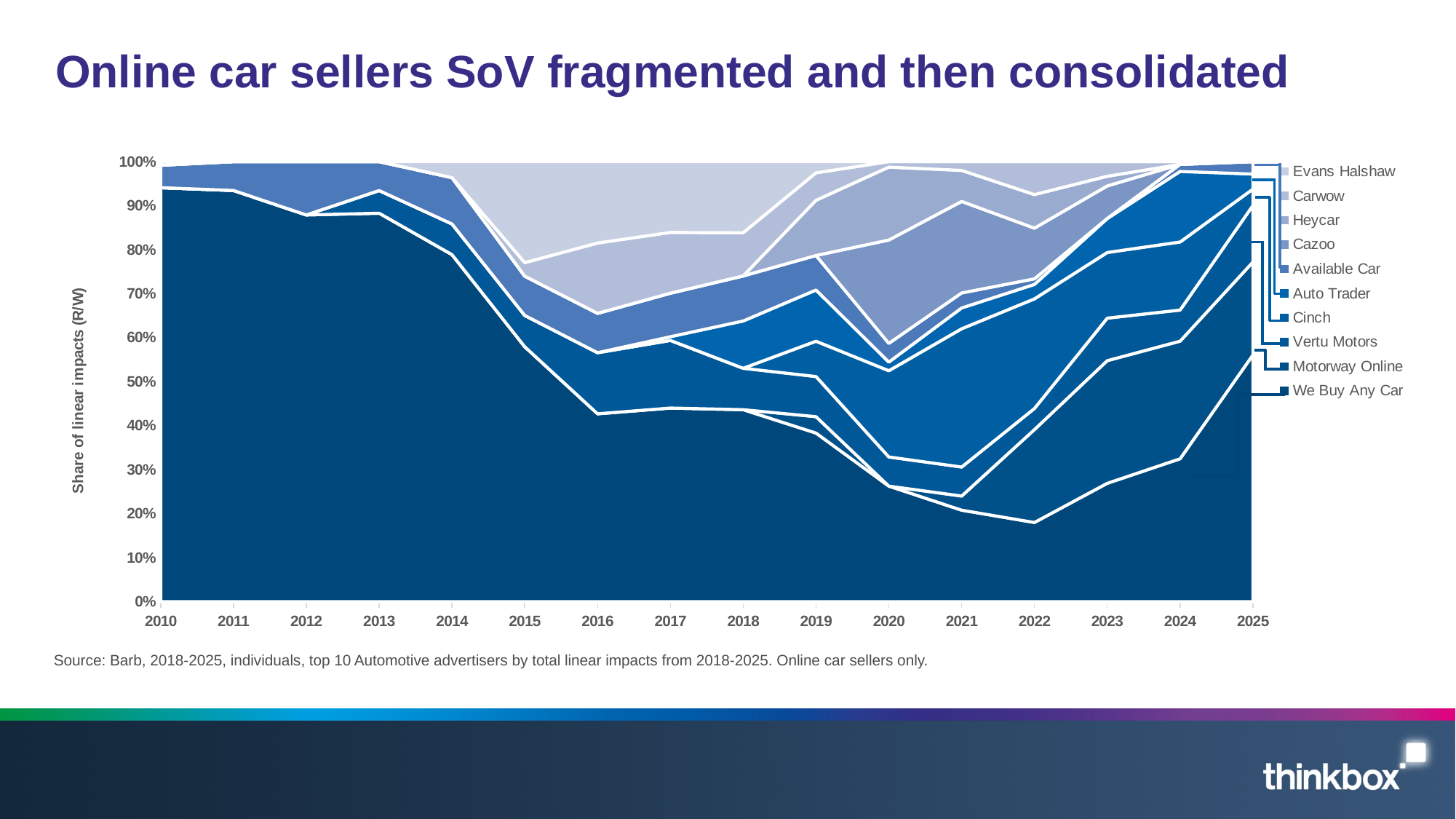
How many series does the legend list? 10 Which series is at the bottom of the stack (listed last in the legend)? We Buy Any Car Does the share for We Buy Any Car rise or fall between 2013 and 2022? fall Is the share for We Buy Any Car in 2010 greater or less than 90%? greater In which year is the share for We Buy Any Car lowest? 2022 How many years are shown along the x axis? 16 What kind of chart is shown on the slide? Stacked area chart Is the share for We Buy Any Car in 2020 greater or less than 30%? less Is the share for We Buy Any Car larger in 2010 or in 2022? 2010 Is the share for We Buy Any Car in 2025 greater or less than 50%? greater What is the label on the y axis? Share of linear impacts (R/W)